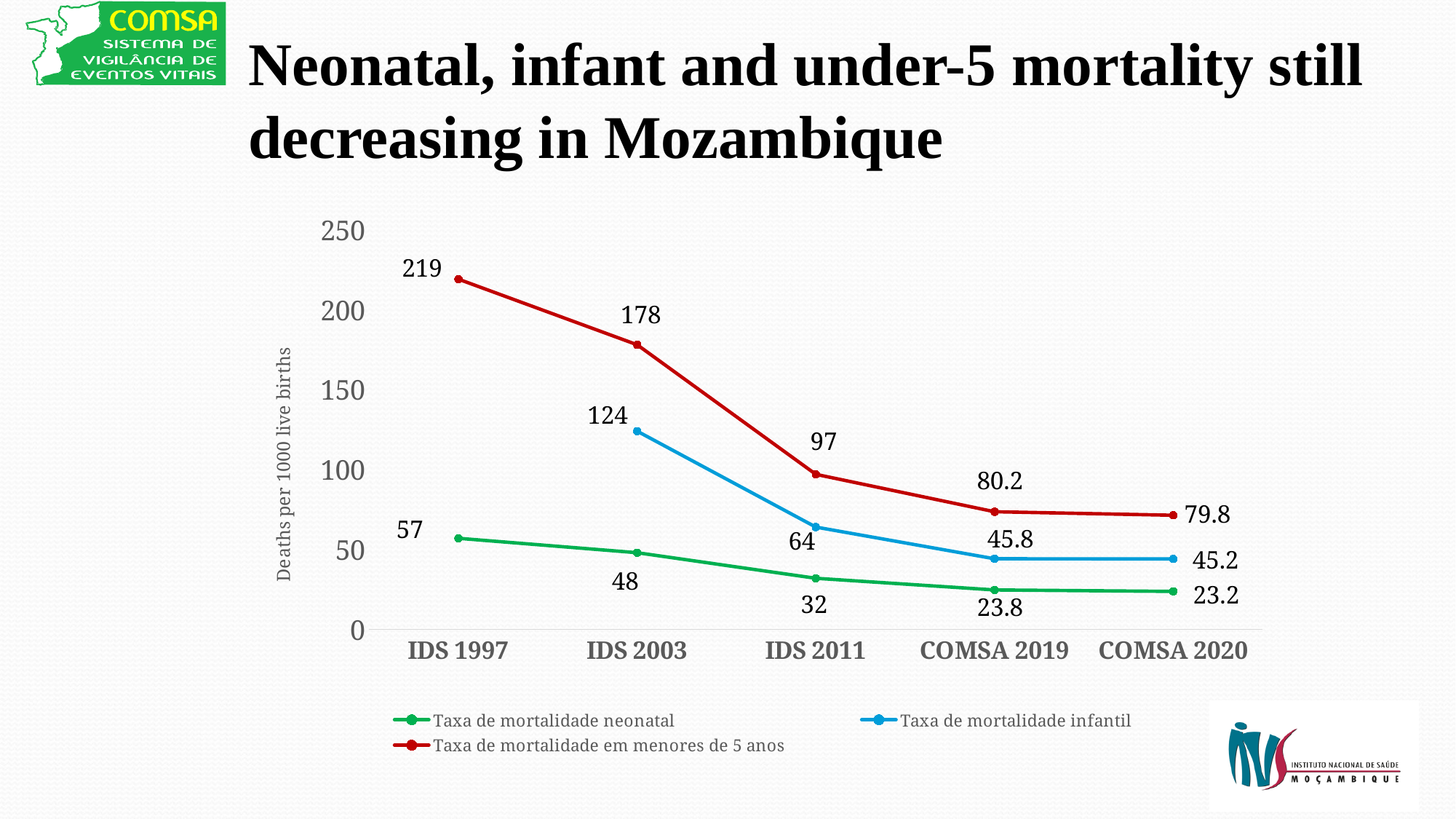
Do the under-5 mortality values rise or fall from IDS 1997 to COMSA 2020? Fall What is the difference between the infant mortality rate and the neonatal mortality rate in IDS 2011? 32 What is the infant mortality rate (Taxa de mortalidade infantil) for IDS 2003? 124 What is the under-5 mortality rate (Taxa de mortalidade em menores de 5 anos) for IDS 1997? 219 What is the neonatal mortality rate (Taxa de mortalidade neonatal) for COMSA 2020? 23.2 In which period is the under-5 mortality rate lowest? COMSA 2020 Which is larger: the infant mortality rate in IDS 2003 or the under-5 mortality rate in IDS 2011? Infant mortality rate in IDS 2003 In which period is the neonatal mortality rate highest? IDS 1997 What is the difference between the under-5 mortality rate in IDS 1997 and in IDS 2003? 41 What kind of chart is shown on the slide? Line chart What is the under-5 mortality rate for COMSA 2019? 80.2 How many series does the legend list? 3